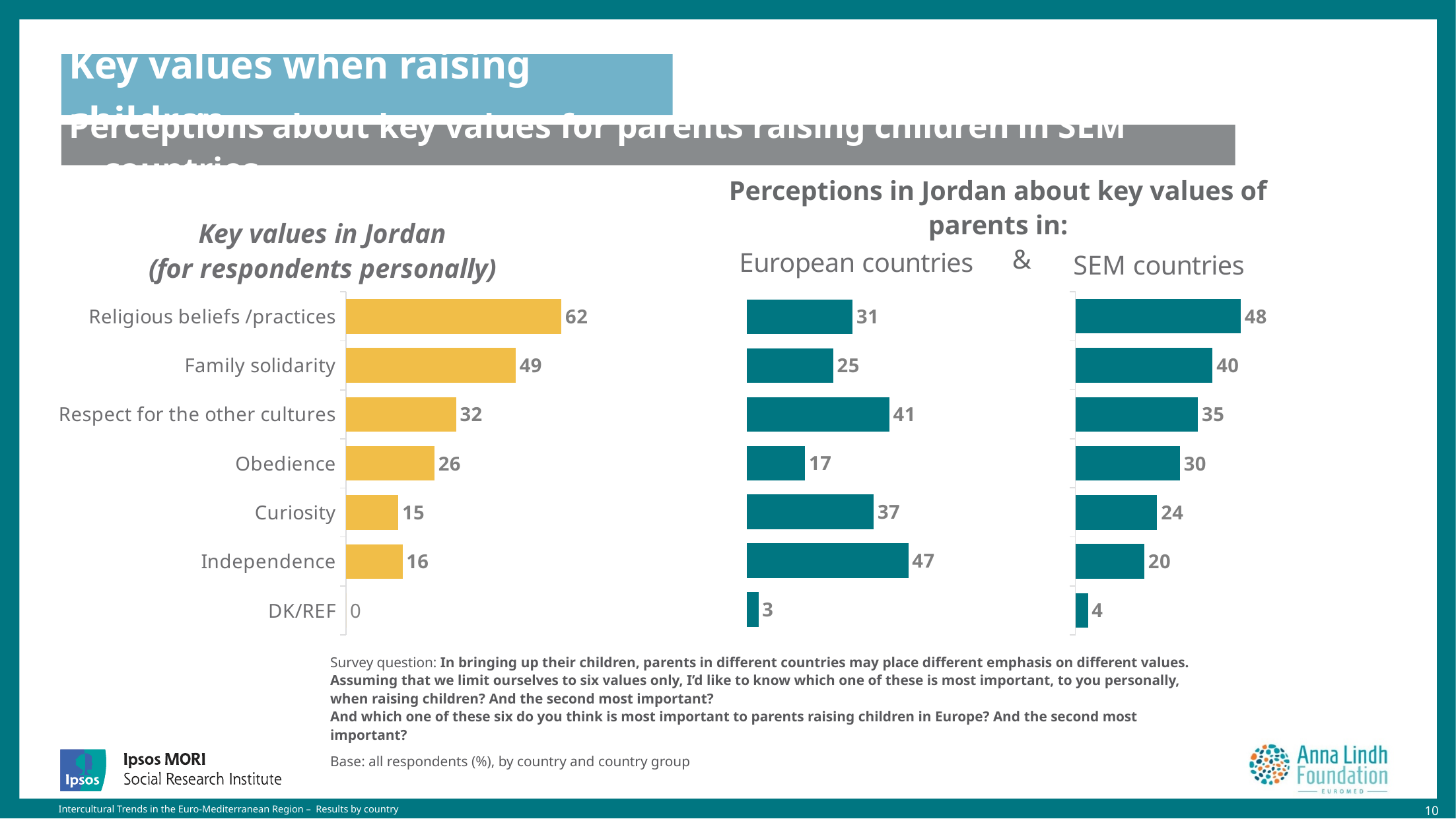
In the 'European countries' chart, what is the value for Independence? 47 In the 'Key values in Jordan (for respondents personally)' chart, what is the difference between Religious beliefs /practices and Family solidarity? 13 In the 'SEM countries' chart, which category has the highest value? Religious beliefs /practices How many categories are shown in the 'Key values in Jordan (for respondents personally)' chart? 7 In the 'European countries' chart, which category (excluding DK/REF) has the lowest value? Obedience Which is larger for Obedience: the European countries value or the SEM countries value? SEM countries In the 'Key values in Jordan (for respondents personally)' chart, which is larger: Curiosity or Independence? Independence In the 'Key values in Jordan (for respondents personally)' chart, what is the value for Family solidarity? 49 In the 'Key values in Jordan (for respondents personally)' chart, which category has the highest value? Religious beliefs /practices What is the difference between the European countries and SEM countries values for Independence? 27 In the 'SEM countries' chart, what is the value for Respect for the other cultures? 35 What type of chart is the 'Key values in Jordan (for respondents personally)' chart? Bar chart